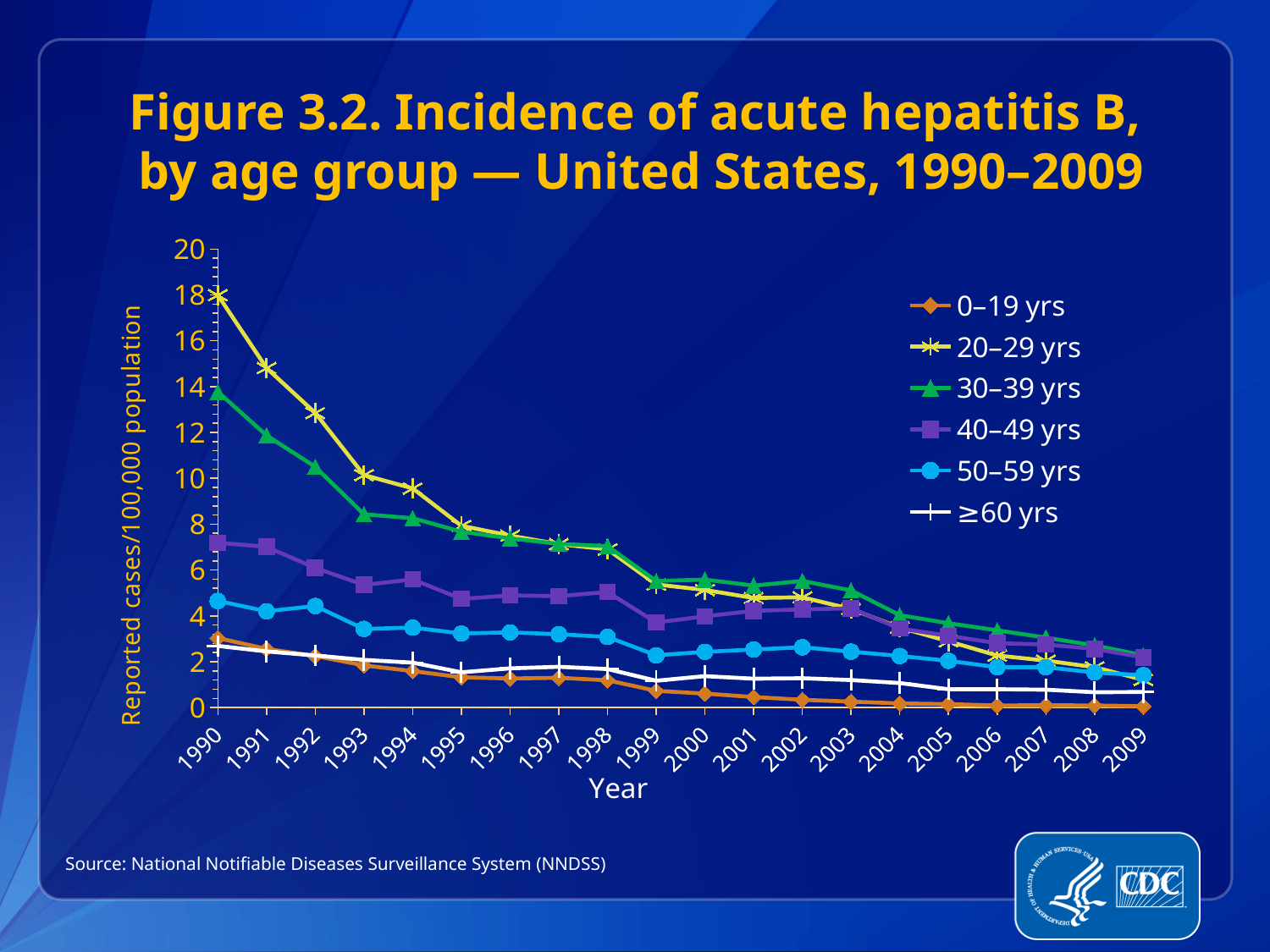
Is the value for 20–29 yrs in 1990 greater or less than 16? greater How many age-group series does the legend list? 6 Is the value for 0–19 yrs in 2009 greater or less than 2? less In 1995, which had the higher incidence: 40–49 yrs or 50–59 yrs? 40–49 yrs Which age group had the highest incidence in 1990? 20–29 yrs Is the value for 30–39 yrs in 1990 greater or less than 12? greater Which age group had the lowest incidence in 2009? 0–19 yrs In 2002, which had the higher incidence: 30–39 yrs or 50–59 yrs? 30–39 yrs How many years are plotted along the x axis? 20 Does the incidence for 20–29 yrs rise or fall from 1990 to 2009? fall What kind of chart is shown on the slide? line chart What is the label on the y axis? Reported cases/100,000 population